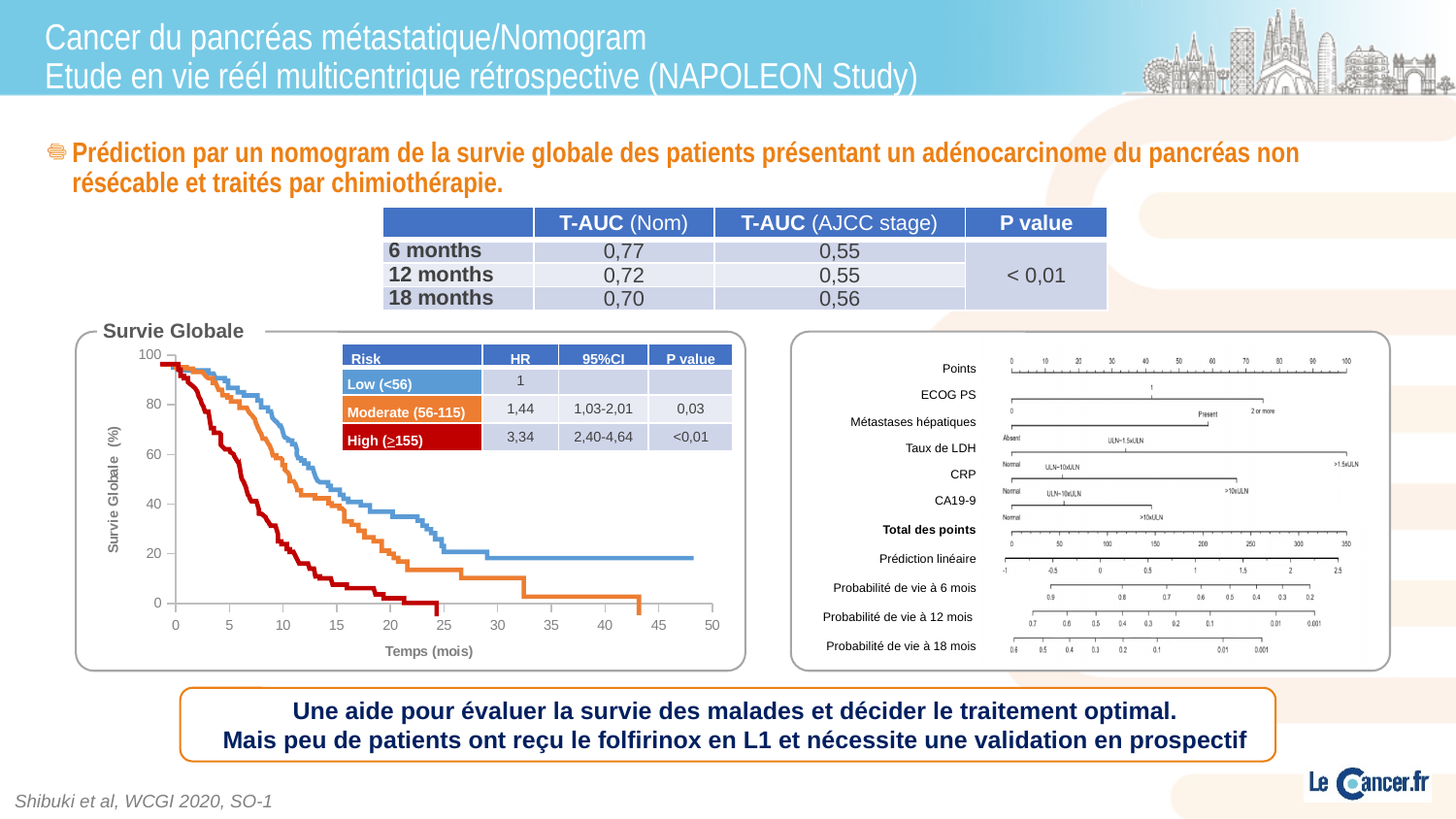
What kind of chart is the 'Survie Globale' chart on the left? line chart In the 'Survie Globale' chart, what is the label of the x axis? Temps (mois) In the 'Survie Globale' chart, which risk group has the lowest survival curve throughout follow-up? High (≥155) In the 'Survie Globale' chart, what is the label of the y axis? Survie Globale (%) In the 'Survie Globale' chart, at 20 months, is the survival of the High (≥155) risk group greater or less than 20%? less In the 'Survie Globale' chart, what is the HR for the High (≥155) risk group? 3,34 In the 'Survie Globale' chart, how many risk groups are plotted? 3 In the nomogram on the right, what is the maximum value shown on the 'Total des points' axis? 350 In the 'Survie Globale' chart, at 20 months, which risk group has the higher survival: Low (<56) or High (≥155)? Low (<56) In the 'Survie Globale' chart, do the survival curves rise or fall as time increases? fall In the 'Survie Globale' chart, what is the HR for the Moderate (56-115) risk group? 1,44 In the 'Survie Globale' chart, at 10 months, is the survival of the Low (<56) risk group greater or less than 60%? greater